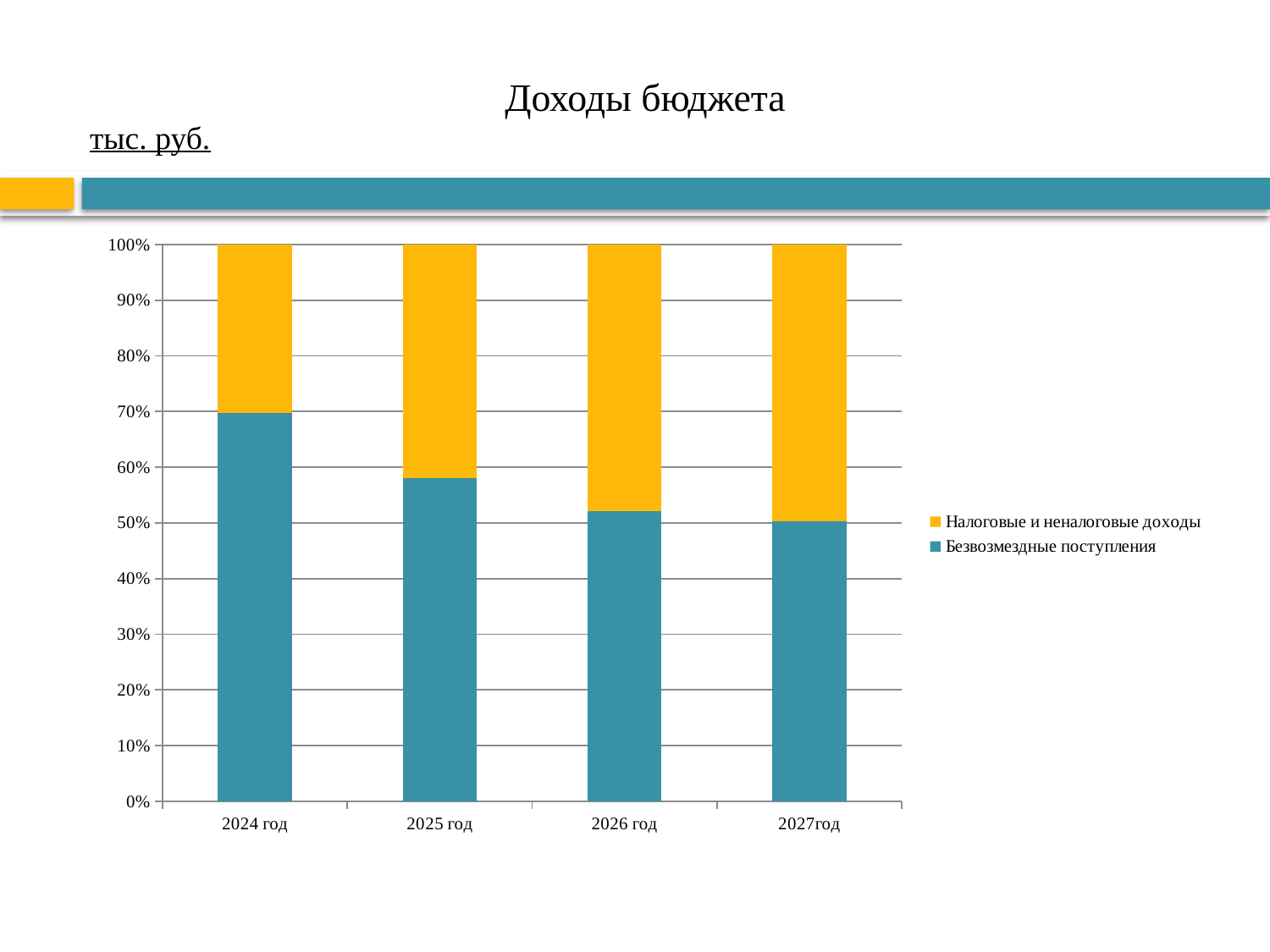
Is the share of Безвозмездные поступления in 2025 год greater or less than 60%? less Which colour represents Налоговые и неналоговые доходы in the chart? yellow Is the share of Безвозмездные поступления in 2024 год greater or less than 60%? greater Is the share of Налоговые и неналоговые доходы in 2024 год greater or less than 40%? less How many series does the chart legend list? 2 Which is larger in 2024 год: the share of Безвозмездные поступления or the share of Налоговые и неналоговые доходы? Безвозмездные поступления Does the share of Безвозмездные поступления rise or fall from 2024 год to 2027год? fall What is the title of the chart? Доходы бюджета How many years are shown on the x axis of the chart? 4 What kind of chart is shown on the slide? stacked bar chart In which year is the share of Безвозмездные поступления the highest? 2024 год